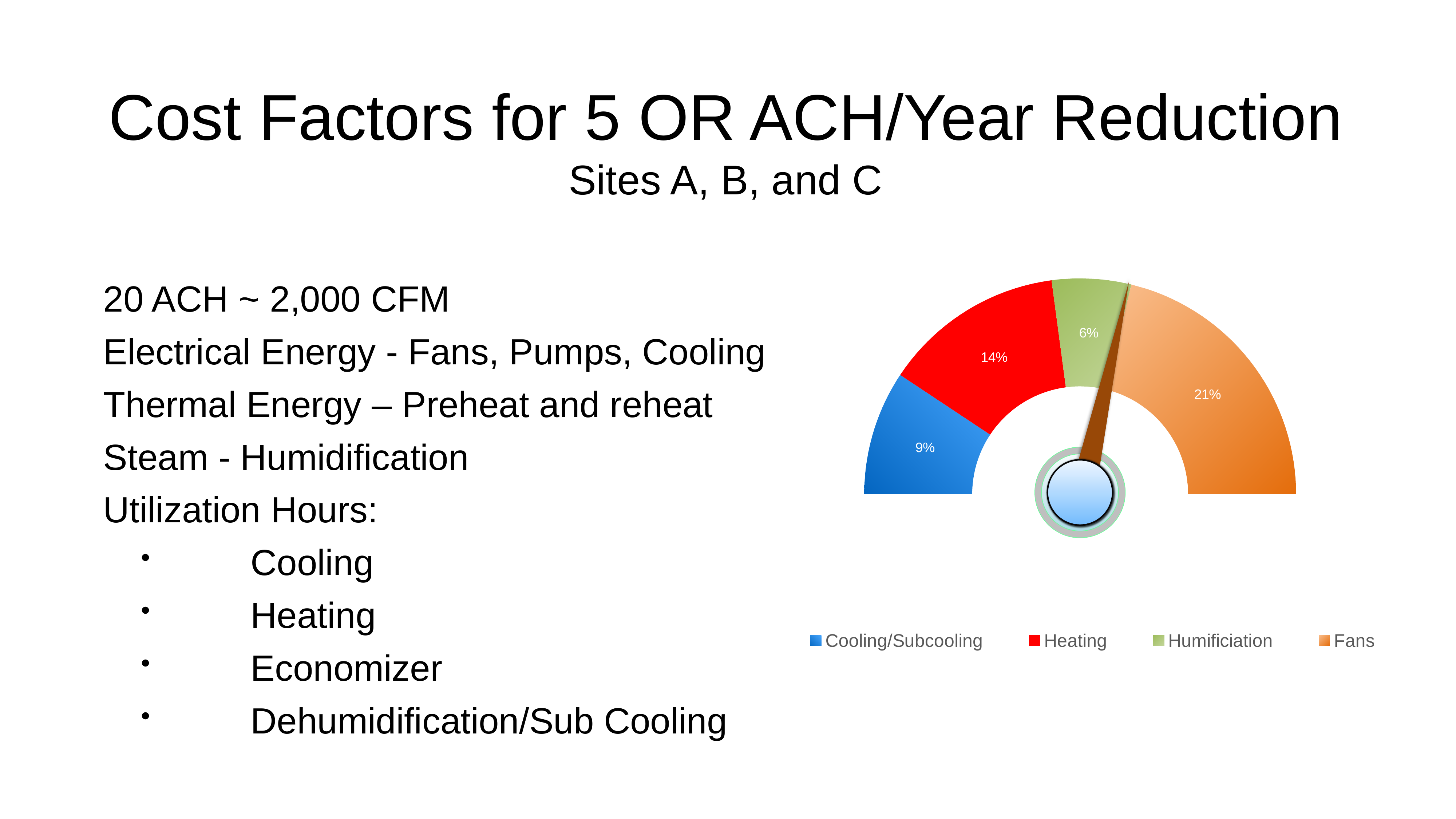
Which segment of the gauge chart has the largest percentage? Fans What percentage is shown for the Heating segment of the gauge chart? 14% What is the difference in percentage points between the Fans segment and the Heating segment? 7% How many labelled segments does the gauge chart have? 4 What percentage is shown for the Cooling/Subcooling segment of the gauge chart? 9% Which segment of the gauge chart has the smallest percentage? Humificiation How many entries does the chart legend list? 4 What kind of chart is shown on the slide? Gauge (doughnut) chart What percentage is shown for the Fans segment of the gauge chart? 21% What colour represents Heating in the chart legend? Red Which is larger, the Heating segment or the Cooling/Subcooling segment? Heating What percentage is shown for the Humificiation segment of the gauge chart? 6%